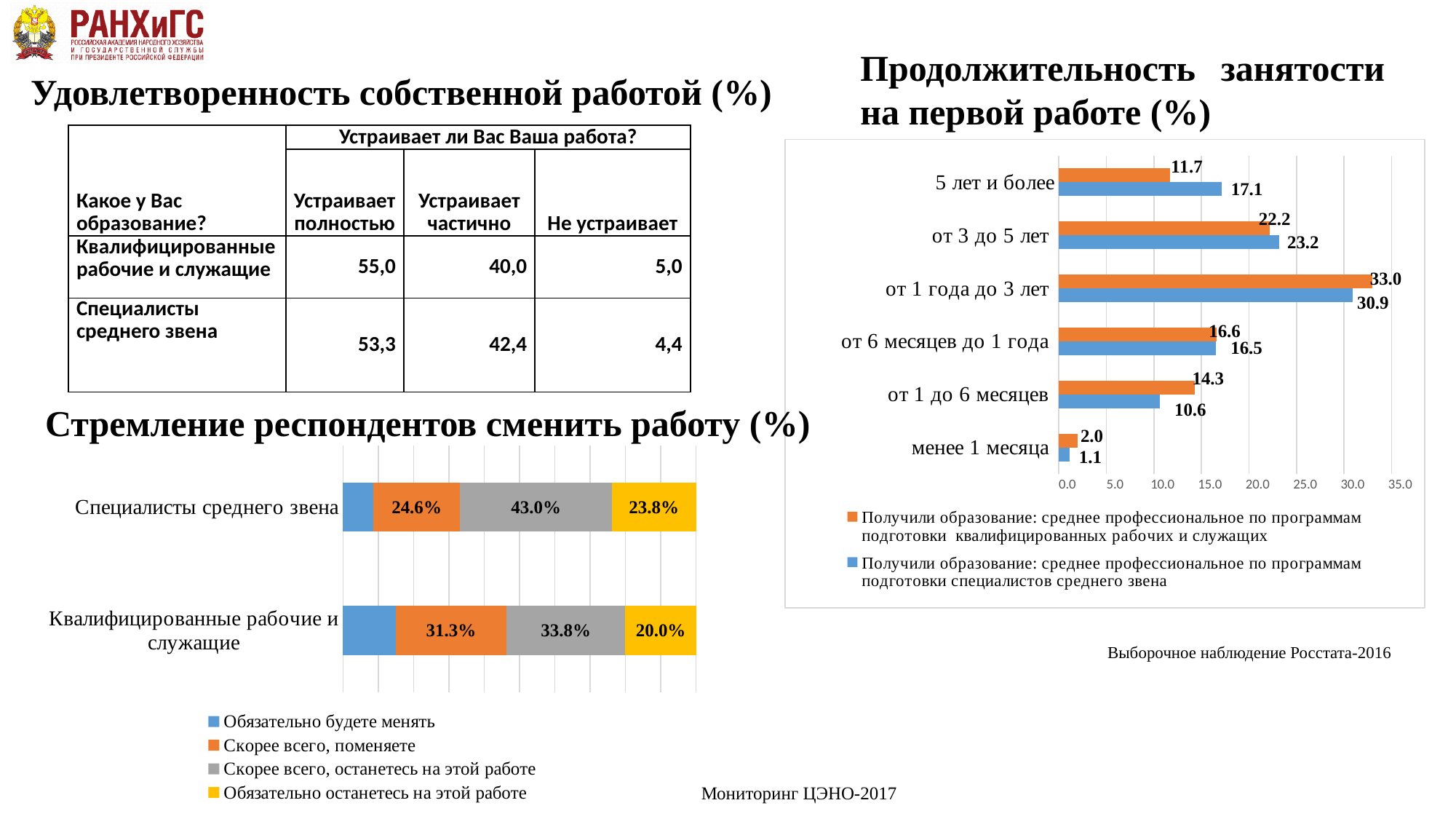
How many categories are shown in the chart 'Продолжительность занятости на первой работе (%)'? 6 In the chart 'Продолжительность занятости на первой работе (%)', for '5 лет и более', which series has the larger value? Получили образование: среднее профессиональное по программам подготовки специалистов среднего звена In the chart 'Стремление респондентов сменить работу (%)', which category has the larger value for 'Скорее всего, поменяете'? Квалифицированные рабочие и служащие In the chart 'Продолжительность занятости на первой работе (%)', which category has the lowest value for the series 'подготовки квалифицированных рабочих и служащих'? менее 1 месяца In the chart 'Продолжительность занятости на первой работе (%)', what is the difference between the two series for 'от 1 до 6 месяцев'? 3.7 In the chart 'Стремление респондентов сменить работу (%)', what is the value of 'Скорее всего, останетесь на этой работе' for 'Специалисты среднего звена'? 43.0% In the chart 'Продолжительность занятости на первой работе (%)', what is the value for 'менее 1 месяца' for the series 'Получили образование: среднее профессиональное по программам подготовки специалистов среднего звена'? 1.1 How many series does the legend of the chart 'Продолжительность занятости на первой работе (%)' list? 2 What kind of chart is 'Стремление респондентов сменить работу (%)'? Stacked bar chart In the chart 'Продолжительность занятости на первой работе (%)', what is the value for 'от 1 года до 3 лет' for the series 'Получили образование: среднее профессиональное по программам подготовки квалифицированных рабочих и служащих'? 33.0 How many series does the legend of the chart 'Стремление респондентов сменить работу (%)' list? 4 In the chart 'Продолжительность занятости на первой работе (%)', which category has the highest value for the series 'подготовки специалистов среднего звена'? от 1 года до 3 лет